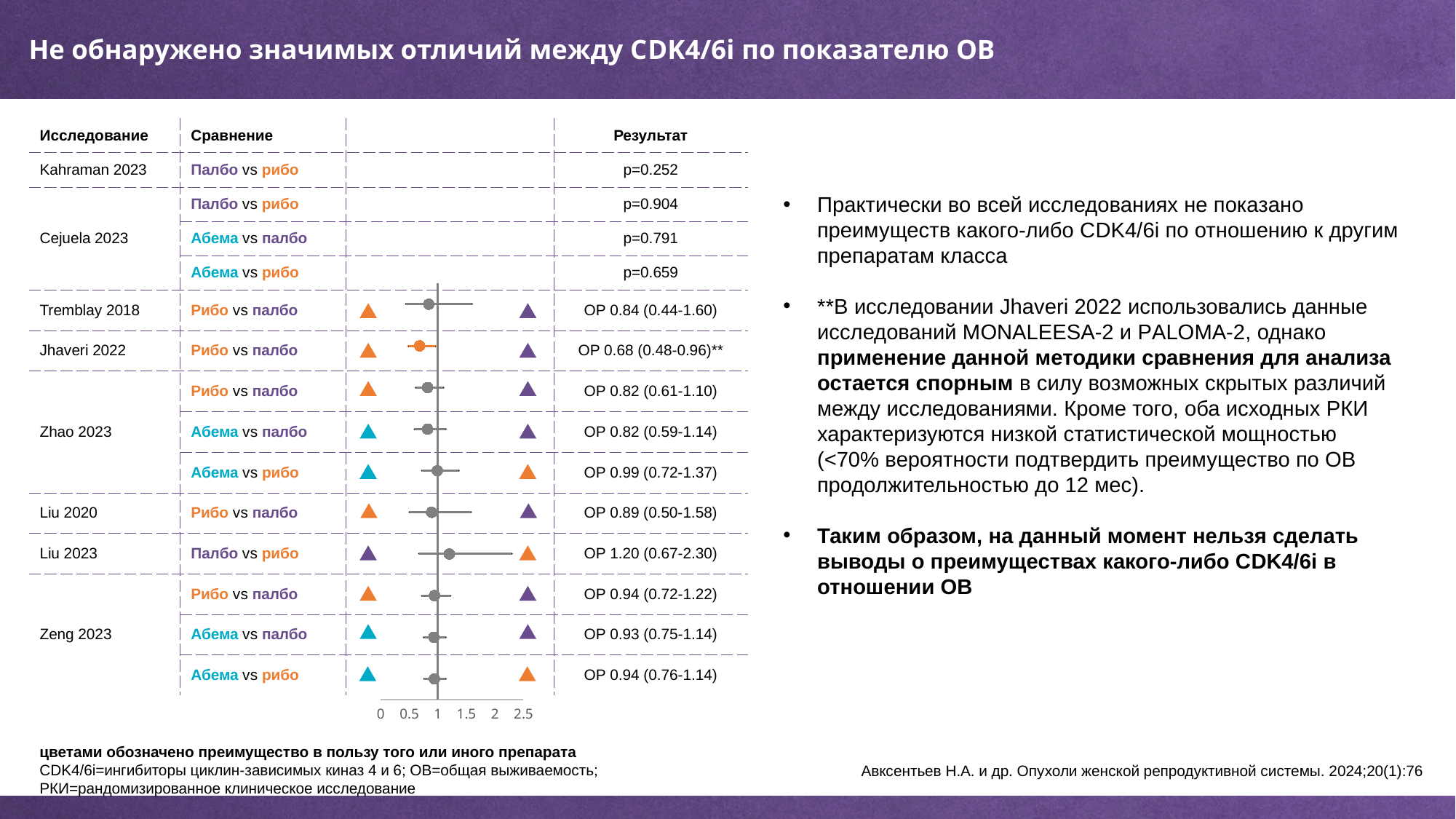
Is the ОР point estimate for Liu 2023 greater or less than 1? greater What is the difference between the ОР point estimates of Liu 2023 and Jhaveri 2022? 0.52 Which study row has the lowest point estimate of ОР in the forest plot? Jhaveri 2022 Which has the larger ОР point estimate: Liu 2020 (Рибо vs палбо) or Zeng 2023 (Рибо vs палбо)? Zeng 2023 How many comparisons are plotted as points with confidence intervals in the forest plot? 10 What is the hazard ratio (ОР) reported for Tremblay 2018 (Рибо vs палбо)? 0.84 (0.44-1.60) Which study row has the highest point estimate of ОР in the forest plot? Liu 2023 What is the hazard ratio (ОР) for the Абема vs рибо comparison in Zhao 2023? 0.99 (0.72-1.37) What is the hazard ratio (ОР) reported for Jhaveri 2022? 0.68 (0.48-0.96) What is the hazard ratio (ОР) for Liu 2023 (Палбо vs рибо)? 1.20 (0.67-2.30) What p-value is reported for Kahraman 2023? p=0.252 What kind of chart is shown on the slide? Forest plot